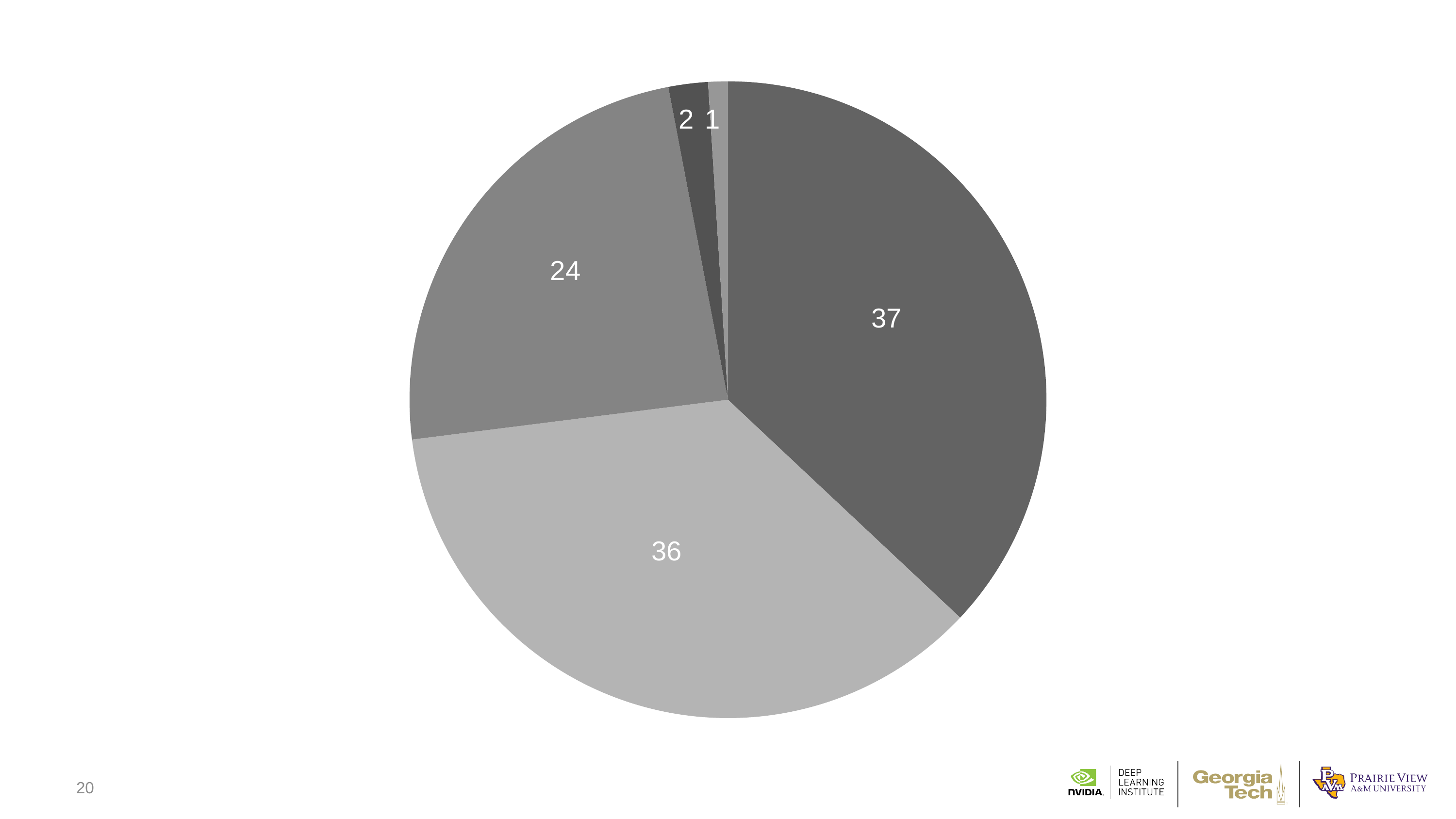
What is the smallest value labelled on the pie chart? 1 What is the sum of all the slice values shown on the pie chart? 100 What share of the pie does the slice labelled 37 represent? 37% What is the value labelled on the slice in the upper-left part of the pie chart? 24 What kind of chart is shown on the slide? pie chart What is the difference between the slice labelled 36 and the slice labelled 24? 12 What is the largest value labelled on the pie chart? 37 What is the value labelled on the large slice on the right side of the pie chart? 37 What is the value labelled on the lightest grey slice at the bottom of the pie chart? 36 What is the difference between the two largest slice values, 37 and 36? 1 Which is larger, the slice labelled 24 or the slice labelled 2? 24 How many slices does the pie chart have? 5